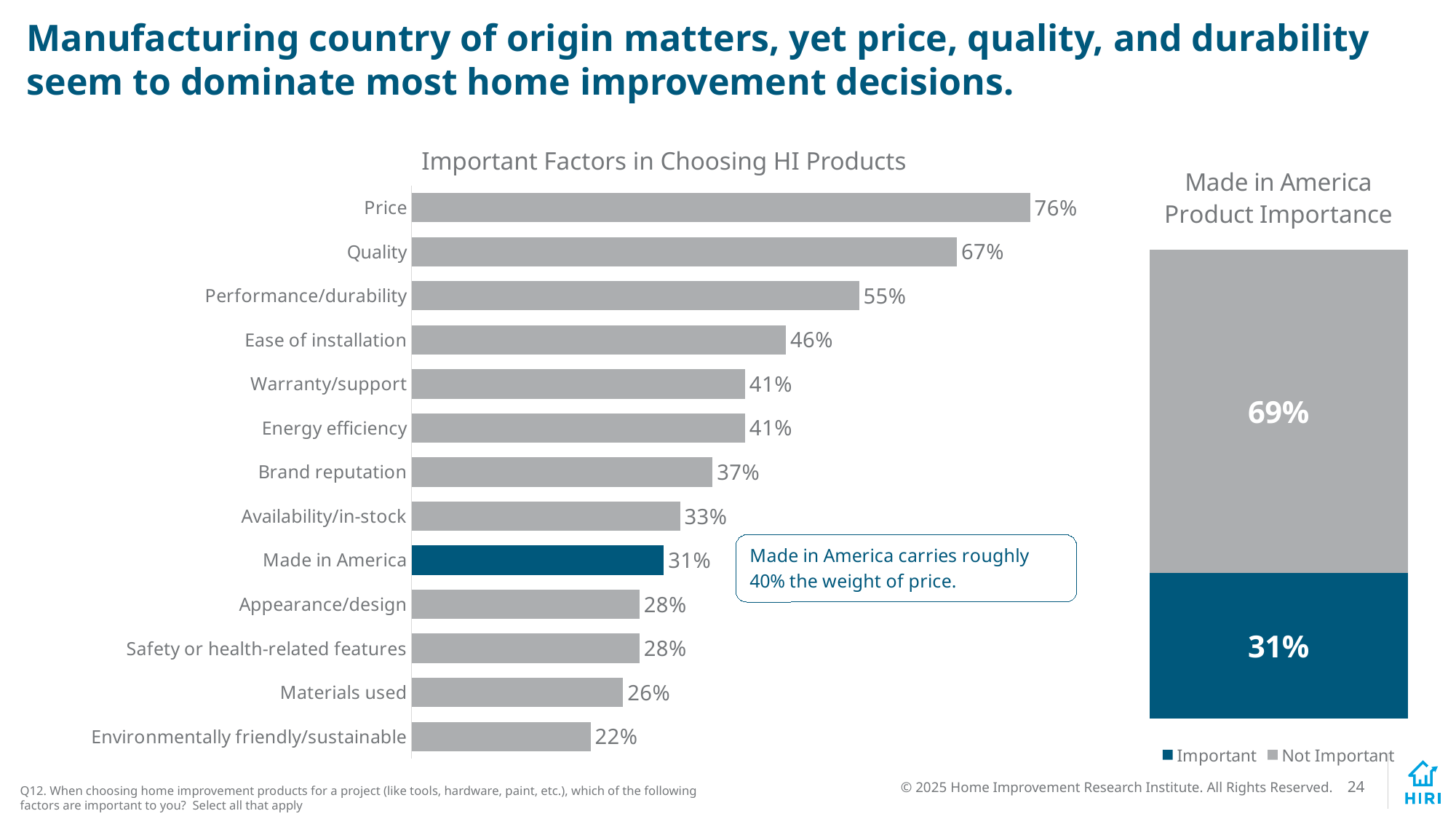
How many series does the legend of the 'Made in America Product Importance' chart list? 2 How many factors are listed in the 'Important Factors in Choosing HI Products' chart? 13 In the 'Important Factors in Choosing HI Products' chart, what is the value for Made in America? 31% In the 'Important Factors in Choosing HI Products' chart, which factor has the lowest value? Environmentally friendly/sustainable What kind of chart is 'Important Factors in Choosing HI Products'? Bar chart In the 'Made in America Product Importance' chart, what share is Not Important? 69% In the 'Important Factors in Choosing HI Products' chart, which is larger: Ease of installation or Brand reputation? Ease of installation In the 'Important Factors in Choosing HI Products' chart, what is the value for Price? 76% In the 'Important Factors in Choosing HI Products' chart, which bar is coloured dark blue instead of grey? Made in America In the 'Important Factors in Choosing HI Products' chart, which factor has the highest value? Price In the 'Important Factors in Choosing HI Products' chart, what is the difference between Price and Quality? 9% In the 'Made in America Product Importance' chart, what share is Important? 31%